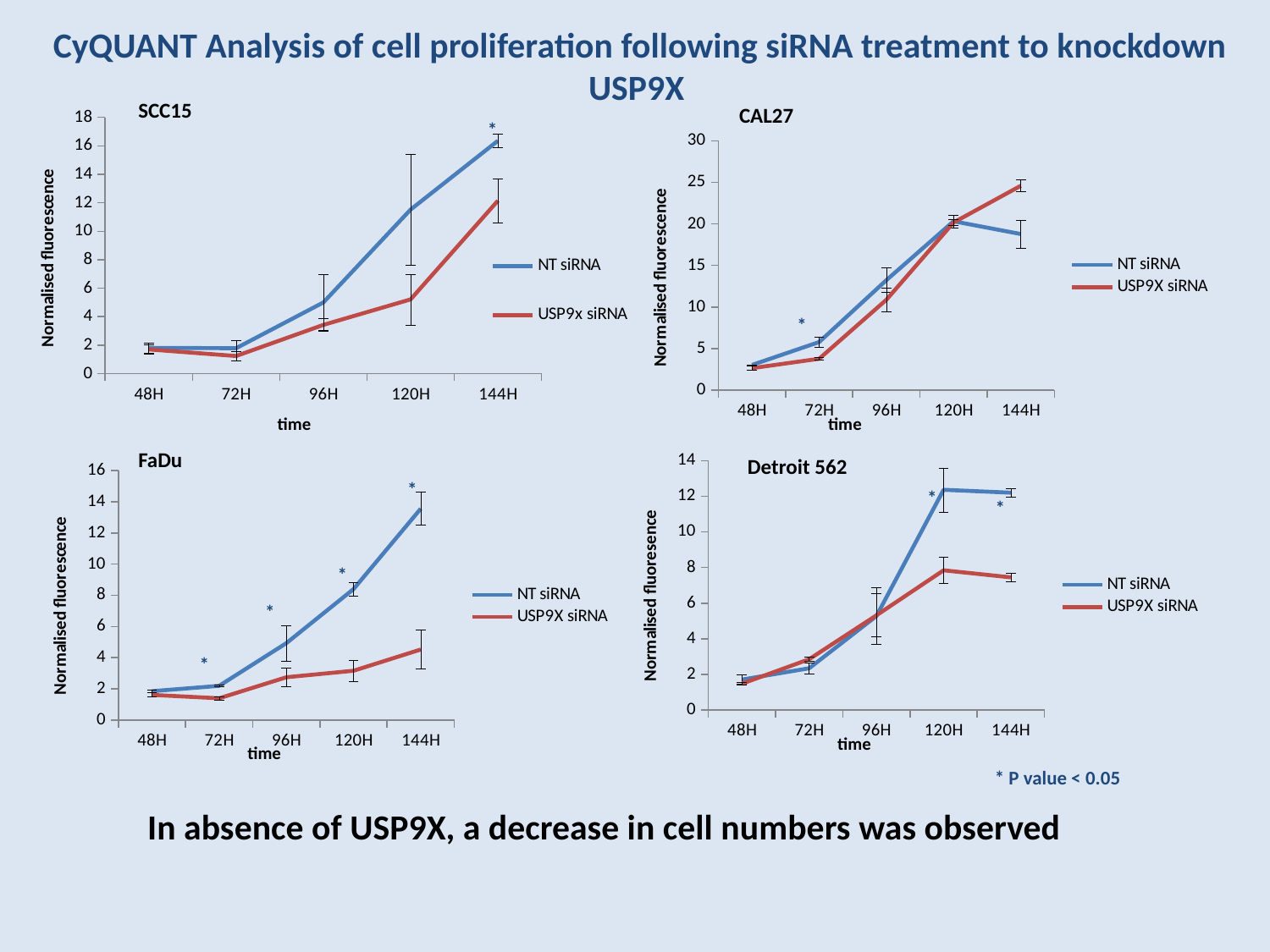
In the CAL27 chart, is the value for USP9X siRNA at 144H greater or less than 20? greater In the Detroit 562 chart, is the value for NT siRNA at 120H greater or less than 10? greater In the Detroit 562 chart, which series has the larger value at 144H, NT siRNA or USP9X siRNA? NT siRNA In the SCC15 chart, is the value for NT siRNA at 144H greater or less than 14? greater In the CAL27 chart, which series has the larger value at 144H, NT siRNA or USP9X siRNA? USP9X siRNA How many time points are plotted on the x axis of the FaDu chart? 5 In the FaDu chart, at which time point does the NT siRNA series reach its highest value? 144H In the SCC15 chart, does the NT siRNA series generally rise or fall from 48H to 144H? rise How many series does the legend of the CAL27 chart list? 2 What kind of chart is the SCC15 chart? line chart In the SCC15 chart, which series has the larger value at 120H, NT siRNA or USP9x siRNA? NT siRNA